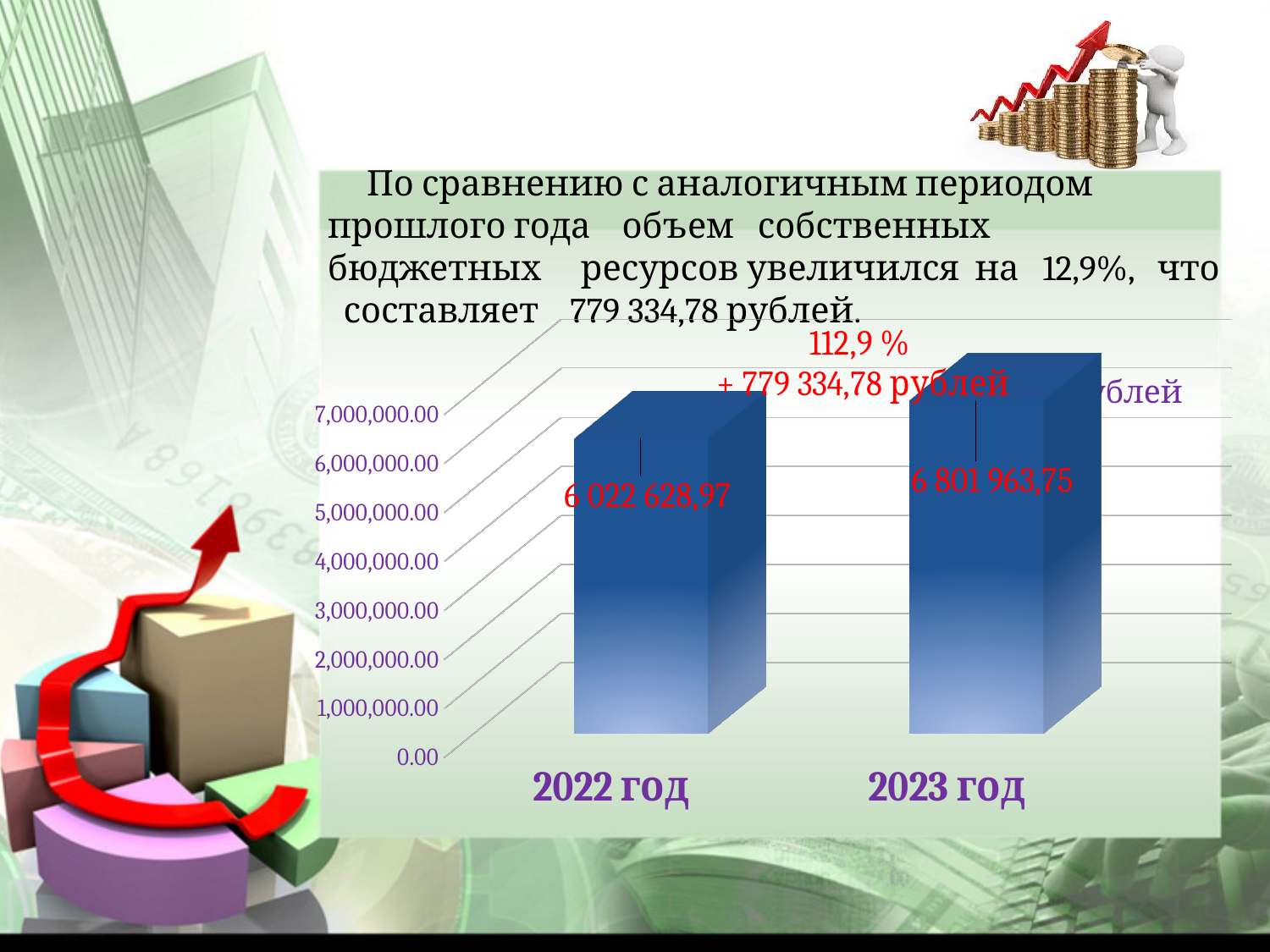
Is the value for 2022 год larger or smaller than the value for 2023 год? smaller Which year has the higher value? 2023 год By how much does the value for 2023 год exceed the value for 2022 год? 779 334,78 How many categories are shown on the x axis? 2 What kind of chart is shown on the slide? bar chart Is the value for 2022 год greater or less than 7,000,000.00? less Do the values rise or fall from 2022 год to 2023 год? rise What is the value for 2023 год? 6 801 963,75 What percentage is written in red above the bars? 112,9 % What is the value for 2022 год? 6 022 628,97 Which year has the lower value? 2022 год Is the value for 2023 год greater or less than 6,000,000.00? greater